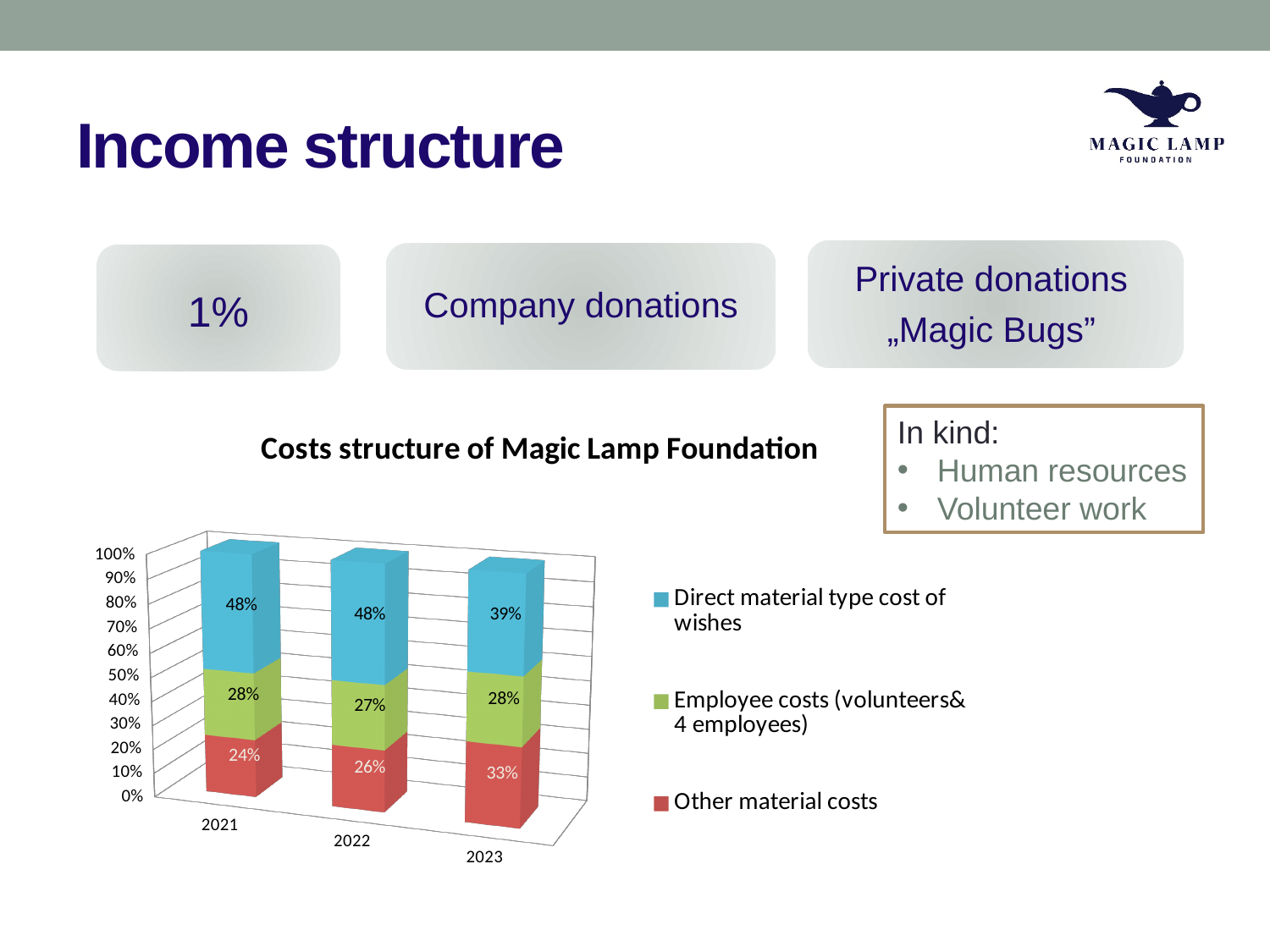
What is the difference between Direct material type cost of wishes in 2021 and in 2023? 9% How many series does the legend list? 3 How many years are shown on the x axis of the chart? 3 Does Other material costs rise or fall from 2021 to 2023? Rise What is the value for Direct material type cost of wishes in 2023? 39% What kind of chart is shown on the slide? Stacked bar chart What is the value for Employee costs (volunteers& 4 employees) in 2022? 27% In which year is Other material costs highest? 2023 What is the title of the chart? Costs structure of Magic Lamp Foundation Which is larger in 2022: Employee costs (volunteers& 4 employees) or Other material costs? Employee costs (volunteers& 4 employees) What is the value for Other material costs in 2021? 24% In which year is Direct material type cost of wishes lowest? 2023